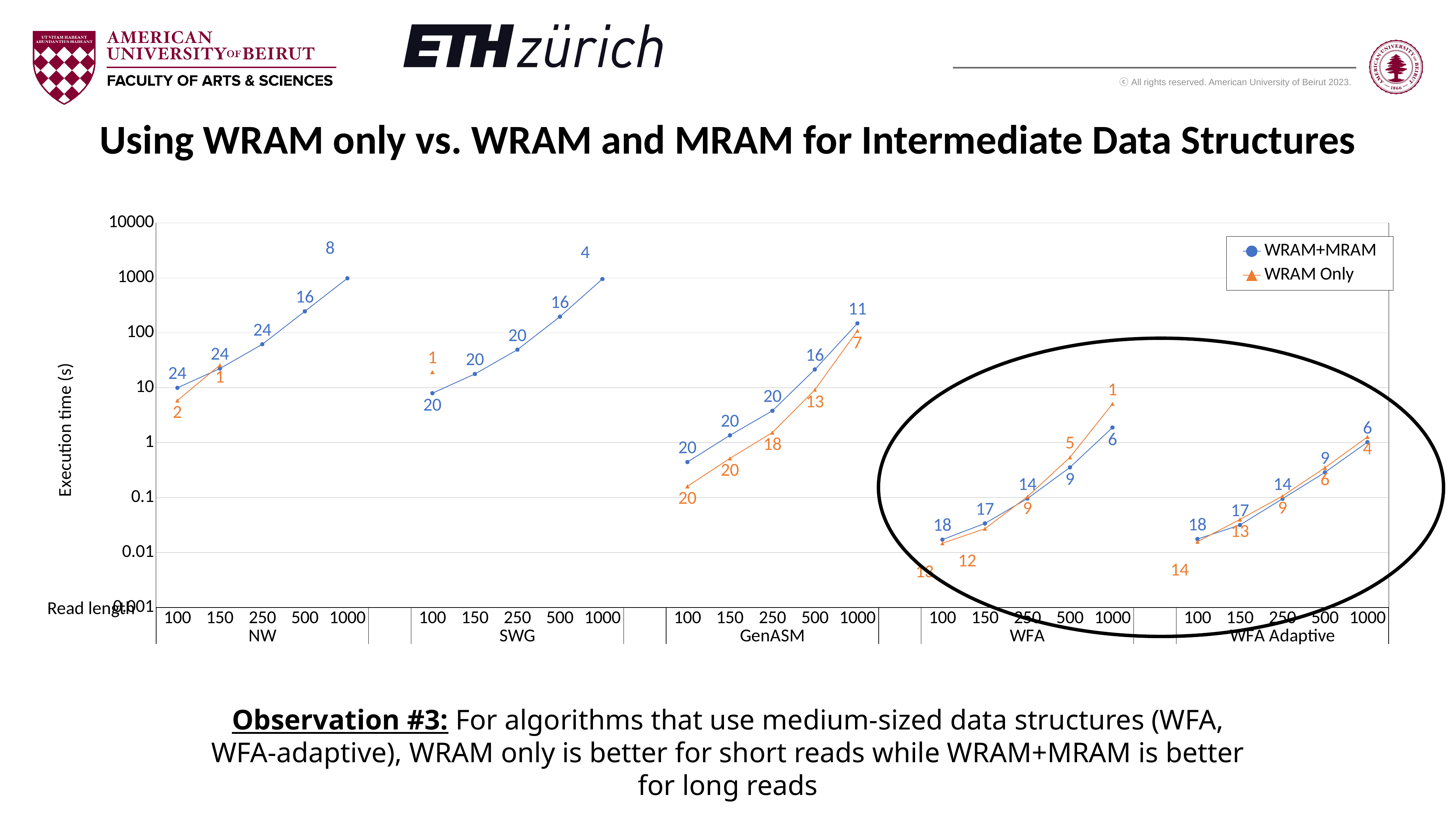
For WFA at read length 1000, which series has the higher execution time, WRAM+MRAM or WRAM Only? WRAM Only For NW at read length 100, which series has the higher execution time, WRAM+MRAM or WRAM Only? WRAM+MRAM Does execution time rise or fall as read length increases for the NW algorithm? rise How many read lengths are plotted for each algorithm? 5 What are the two series named in the legend? WRAM+MRAM and WRAM Only What is the label of the y axis? Execution time (s) Is the WRAM+MRAM execution time for SWG at read length 100 greater or less than 10? less How many series does the legend list? 2 What kind of chart is shown on the slide? line chart Is the WRAM Only execution time for GenASM at read length 100 greater or less than 0.1? greater Is the WRAM Only execution time for WFA at read length 1000 greater or less than 1? greater How many algorithm groups are shown along the x axis? 5